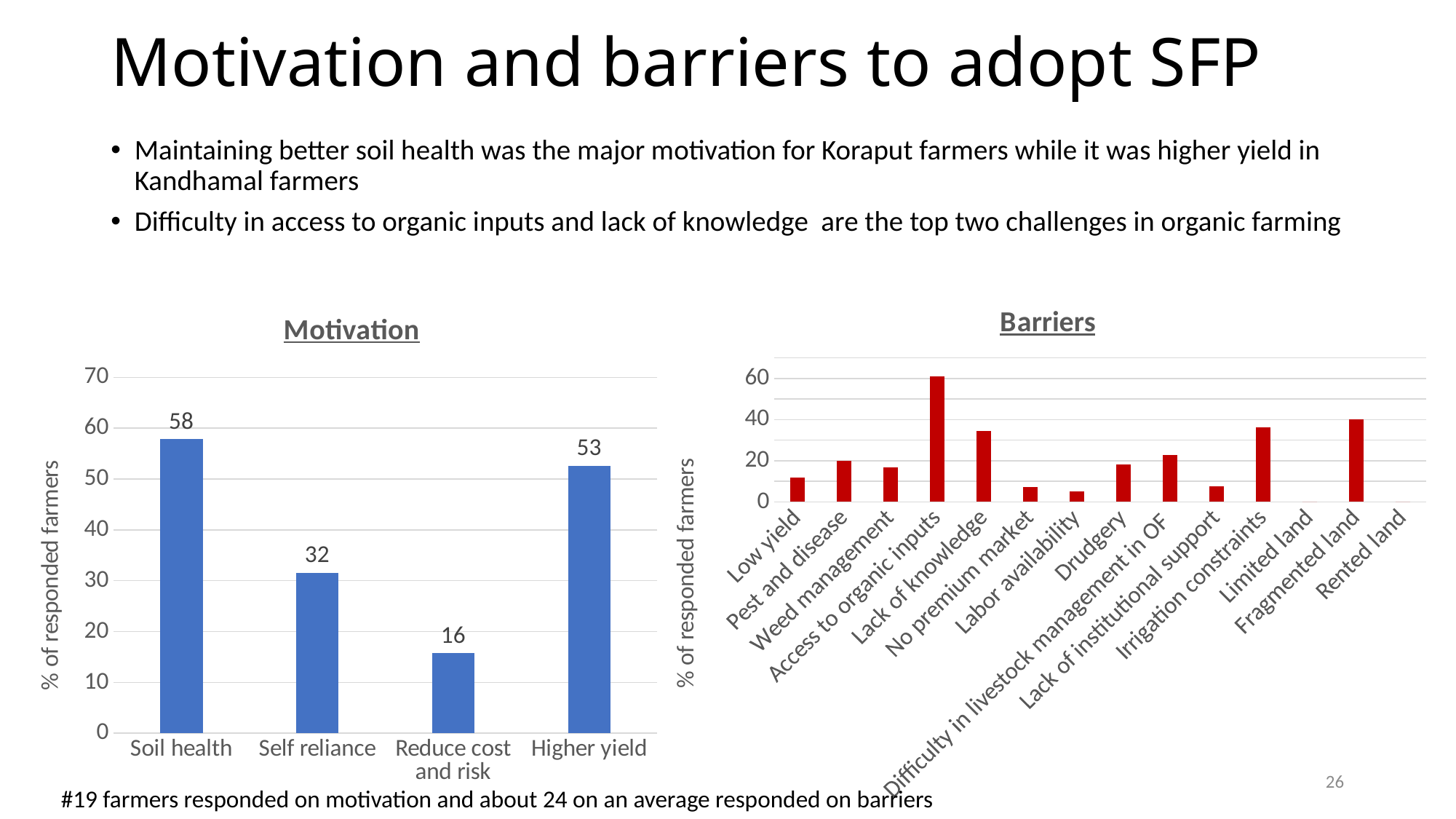
In the Motivation chart, how many categories are shown on the x axis? 4 In the Motivation chart, what is the difference between the values for Soil health and Higher yield? 5 In the Motivation chart, what is the value for Soil health? 58 In the Motivation chart, which category has the highest value? Soil health In the Barriers chart, which category has the highest value? Access to organic inputs What is the y-axis label of the Motivation chart? % of responded farmers In the Motivation chart, what is the value for Reduce cost and risk? 16 In the Barriers chart, is the value for Lack of knowledge greater or less than 40? less In the Barriers chart, is the value for Access to organic inputs greater or less than 40? greater In the Barriers chart, which is larger, the value for Irrigation constraints or the value for Drudgery? Irrigation constraints What kind of chart is the Motivation chart? Bar chart In the Motivation chart, which category has the lowest value? Reduce cost and risk